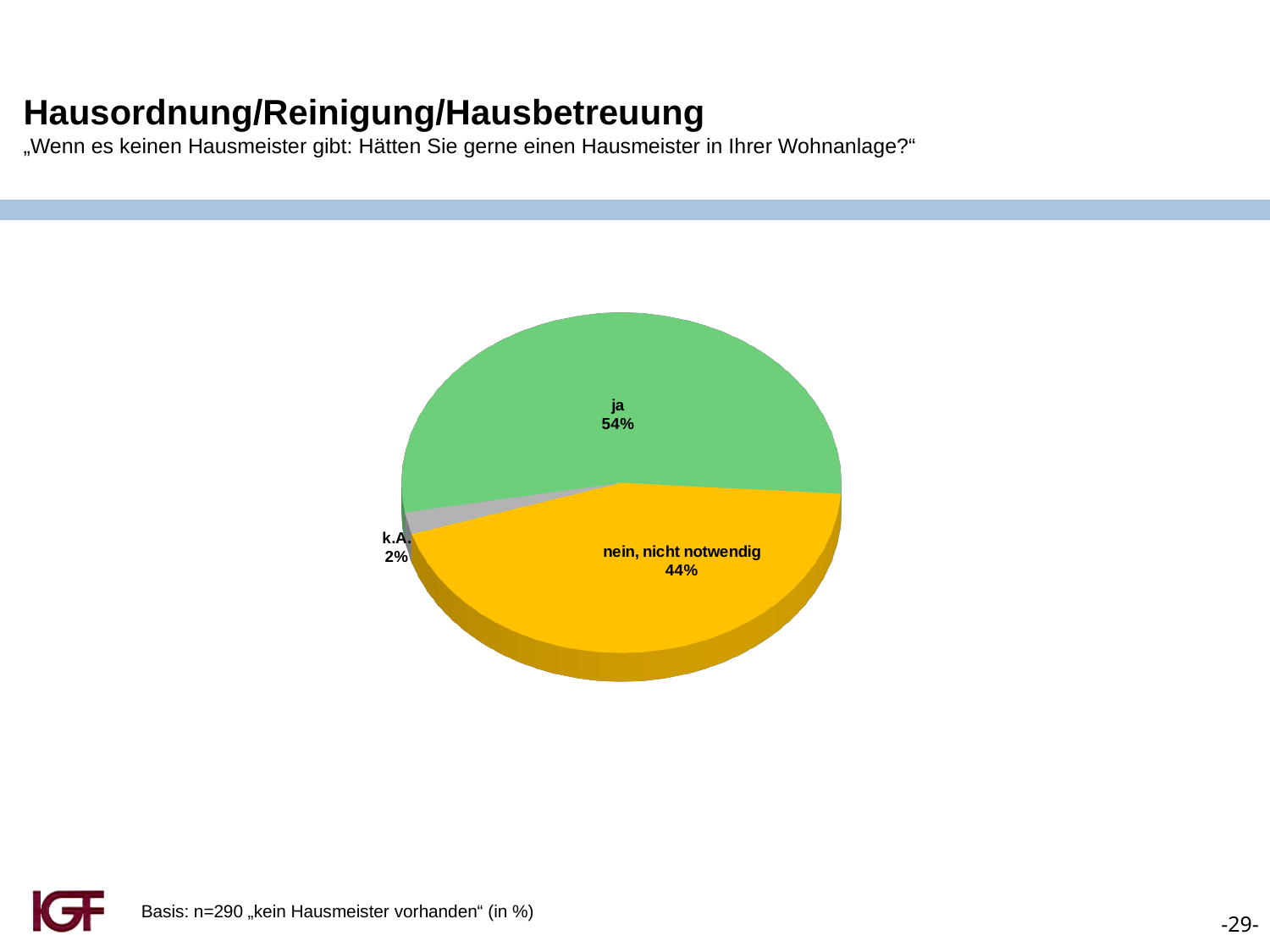
What colour is the "ja" slice of the pie? green How many slices does the pie chart have? 3 What kind of chart is shown on the slide? pie chart Which is larger, the share for "ja" or the share for "nein, nicht notwendig"? ja What percentage of respondents answered "nein, nicht notwendig"? 44% What is the sample size (n) stated in the basis note below the chart? n=290 What is the difference in percentage points between "ja" and "nein, nicht notwendig"? 10 What percentage of respondents answered "ja"? 54% What percentage is shown for "k.A."? 2% What is the combined share of "nein, nicht notwendig" and "k.A."? 46% Which answer category has the smallest share of the pie? k.A. Which answer category has the largest share of the pie? ja